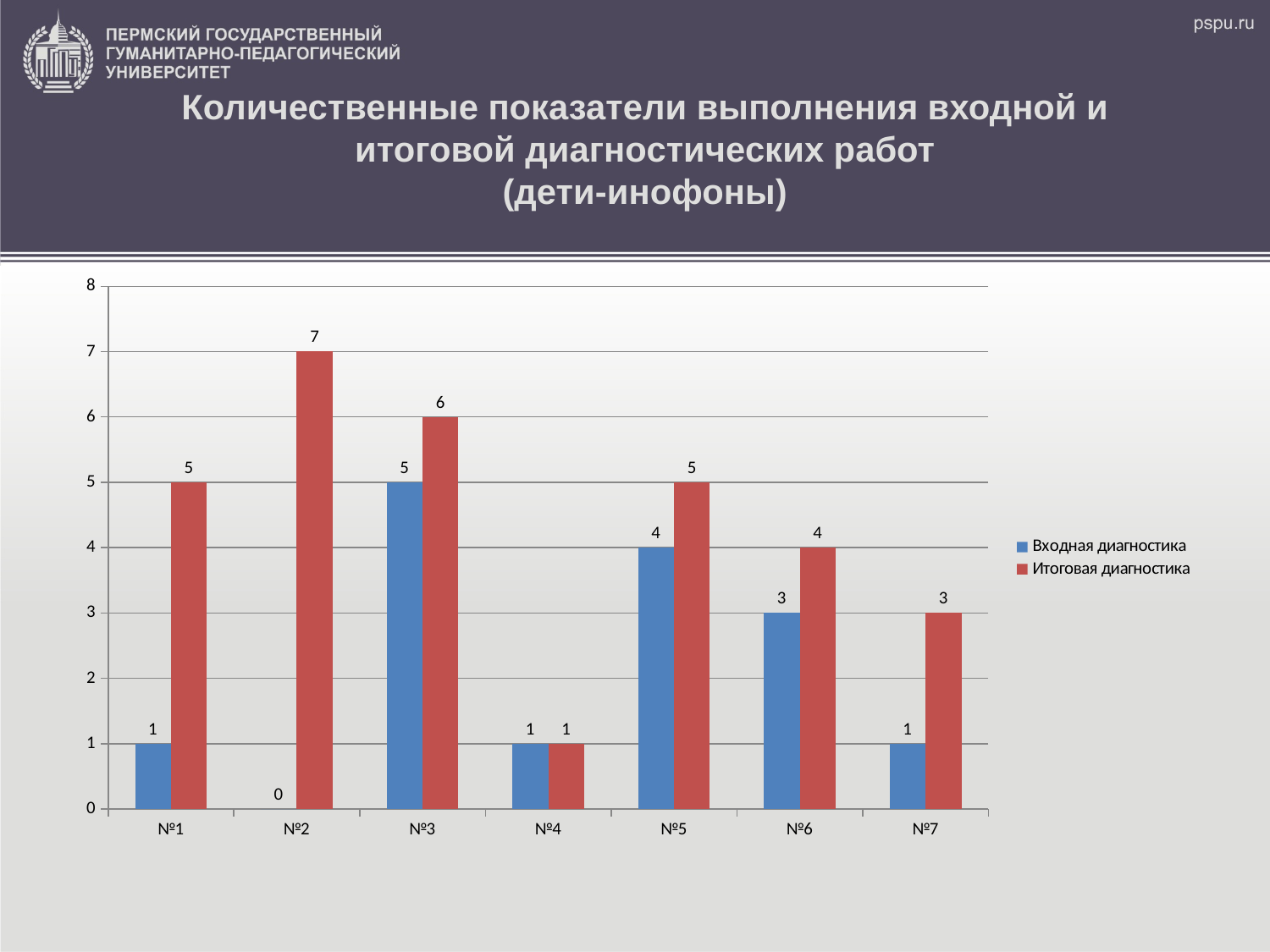
Which category has the lowest value for Входная диагностика? №2 What is the difference between Итоговая диагностика and Входная диагностика for №1? 4 How many series does the legend list? 2 What kind of chart is shown on the slide? Bar chart Which colour represents Входная диагностика in the legend? Blue What is the value of Входная диагностика for №3? 5 Which is larger for №6: Входная диагностика or Итоговая диагностика? Итоговая диагностика How many categories are shown on the x axis? 7 What is the value of Итоговая диагностика for №2? 7 Which category has the highest value for Итоговая диагностика? №2 What is the value of Входная диагностика for №2? 0 What is the value of Итоговая диагностика for №7? 3